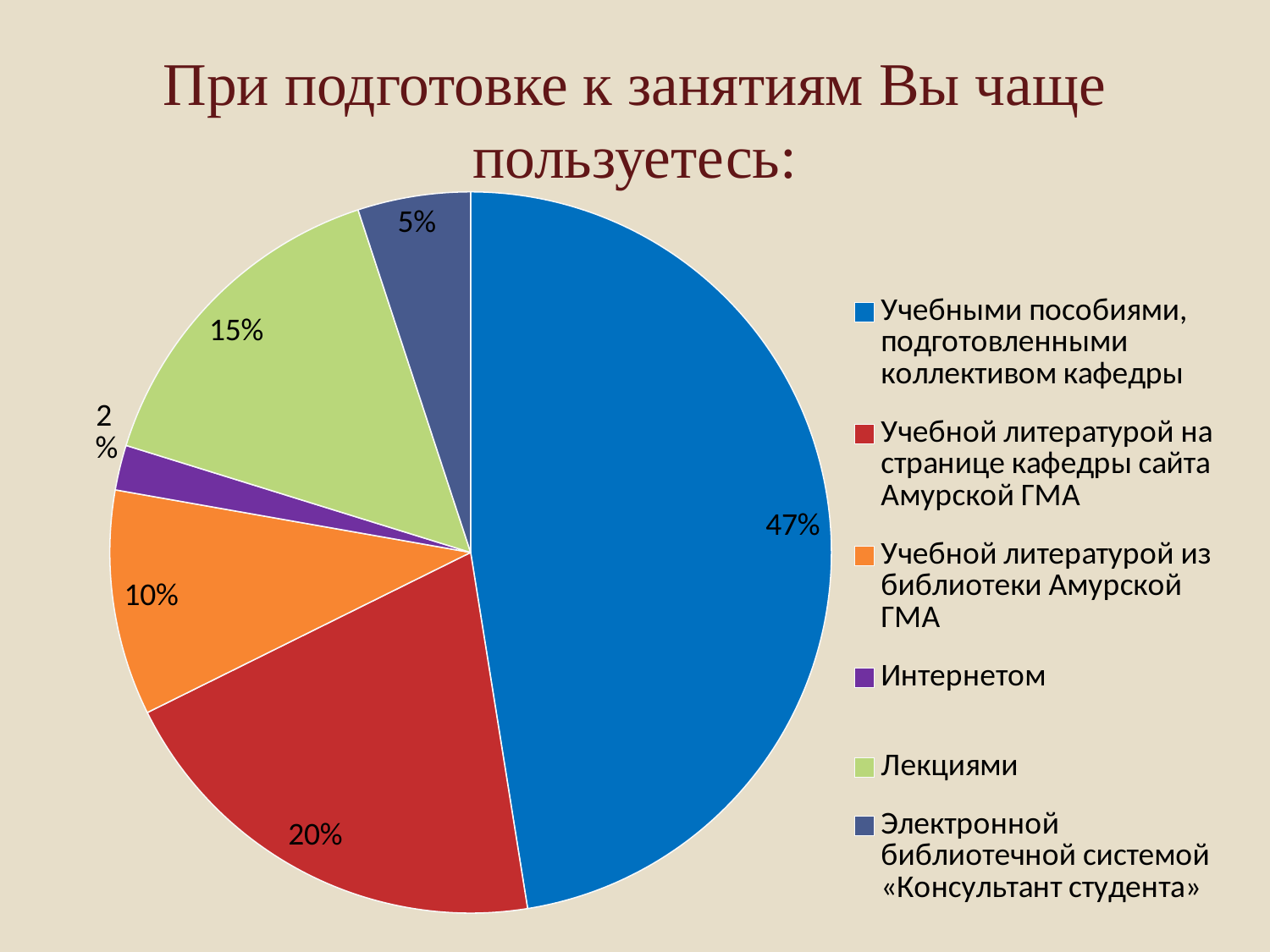
Which category has the smallest slice of the pie? Интернетом Which category has the largest slice of the pie? Учебными пособиями, подготовленными коллективом кафедры What share of the pie is labelled for «Учебной литературой из библиотеки Амурской ГМА»? 10% What share of the pie is labelled for «Лекциями»? 15% Which is larger: the slice for «Лекциями» or the slice for «Учебной литературой из библиотеки Амурской ГМА»? Лекциями What kind of chart is shown on the slide? pie chart What share of the pie is labelled for «Учебной литературой на странице кафедры сайта Амурской ГМА»? 20% How many categories does the legend list? 6 What share of the pie is labelled for «Учебными пособиями, подготовленными коллективом кафедры»? 47% What share of the pie is labelled for «Интернетом»? 2% What share of the pie is labelled for «Электронной библиотечной системой «Консультант студента»»? 5% What is the difference in percentage points between «Учебной литературой на странице кафедры сайта Амурской ГМА» and «Лекциями»? 5